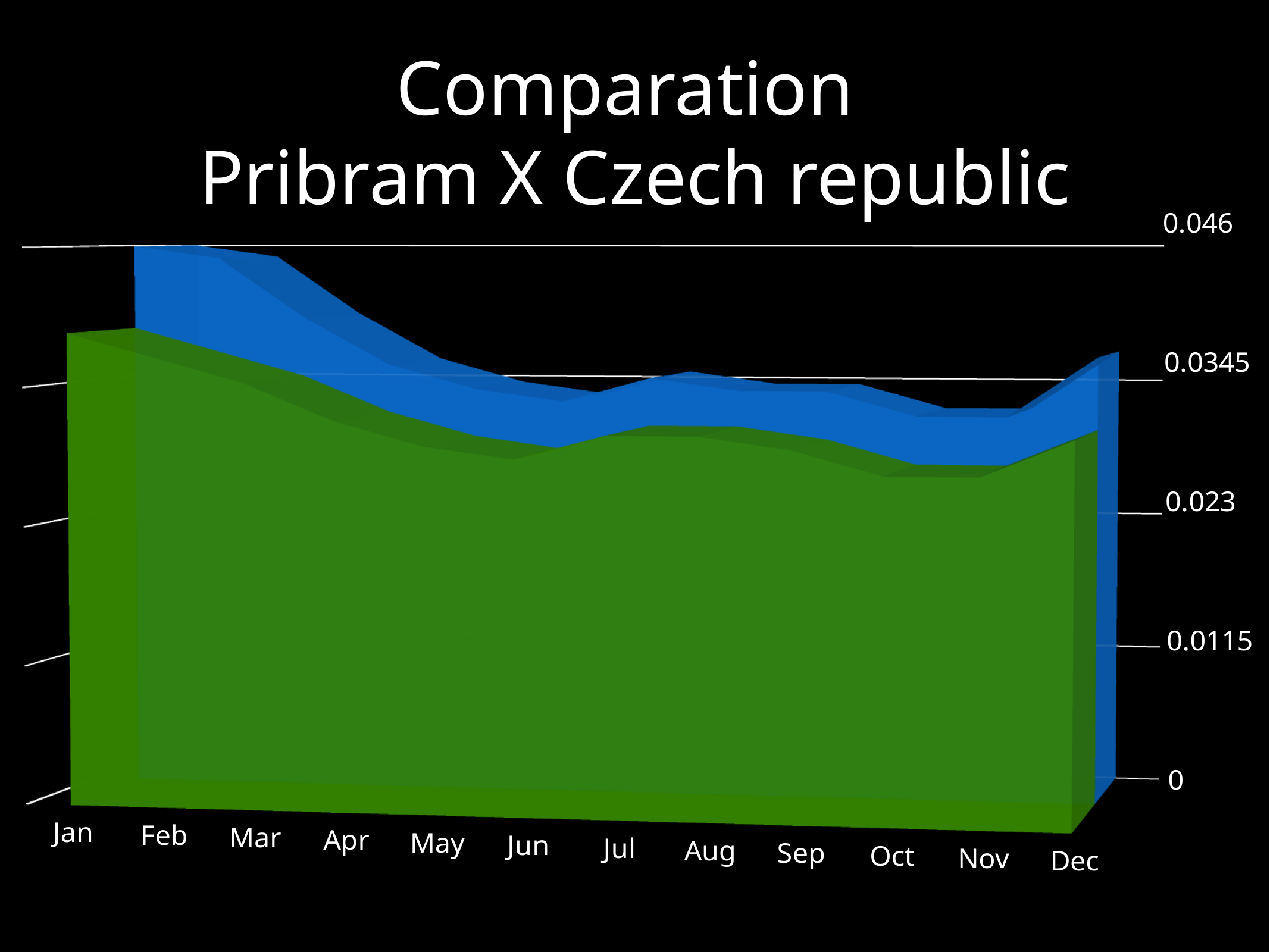
Is the value of the blue series for Jan greater or less than 0.0345? greater What two colours are used for the plotted series? Blue and green Is the value of the green series for Jul greater or less than 0.0345? less How many data series are plotted in the chart? 2 Is the value of the blue series for Nov greater or less than 0.0345? less What kind of chart is shown on the slide? Area chart Which series has the larger value in Jan, the blue series or the green series? Blue series Do the values of the green series rise or fall from Jan to Jun? Fall What is the title of the chart? Comparation Pribram X Czech republic How many months are shown along the x axis? 12